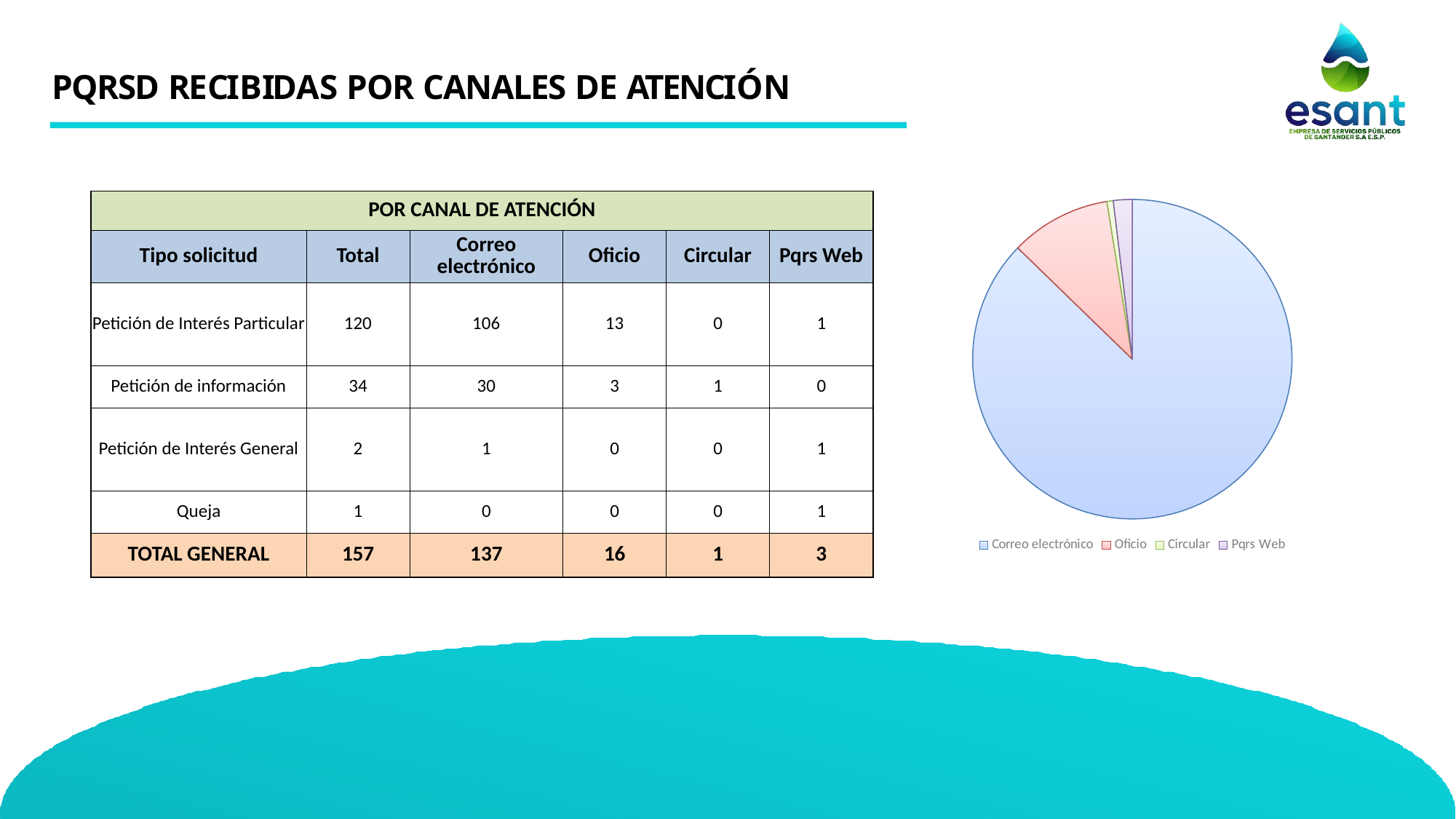
Which legend entry in the pie chart is shown in green? Circular What kind of chart is shown on the slide? pie chart In the pie chart, which slice is larger: Correo electrónico or Oficio? Correo electrónico Which category has the largest slice in the pie chart? Correo electrónico How many entries does the pie chart's legend list? 4 How many slices does the pie chart have? 4 Which legend entry in the pie chart is shown in red? Oficio In the pie chart, which slice is larger: Oficio or Pqrs Web? Oficio